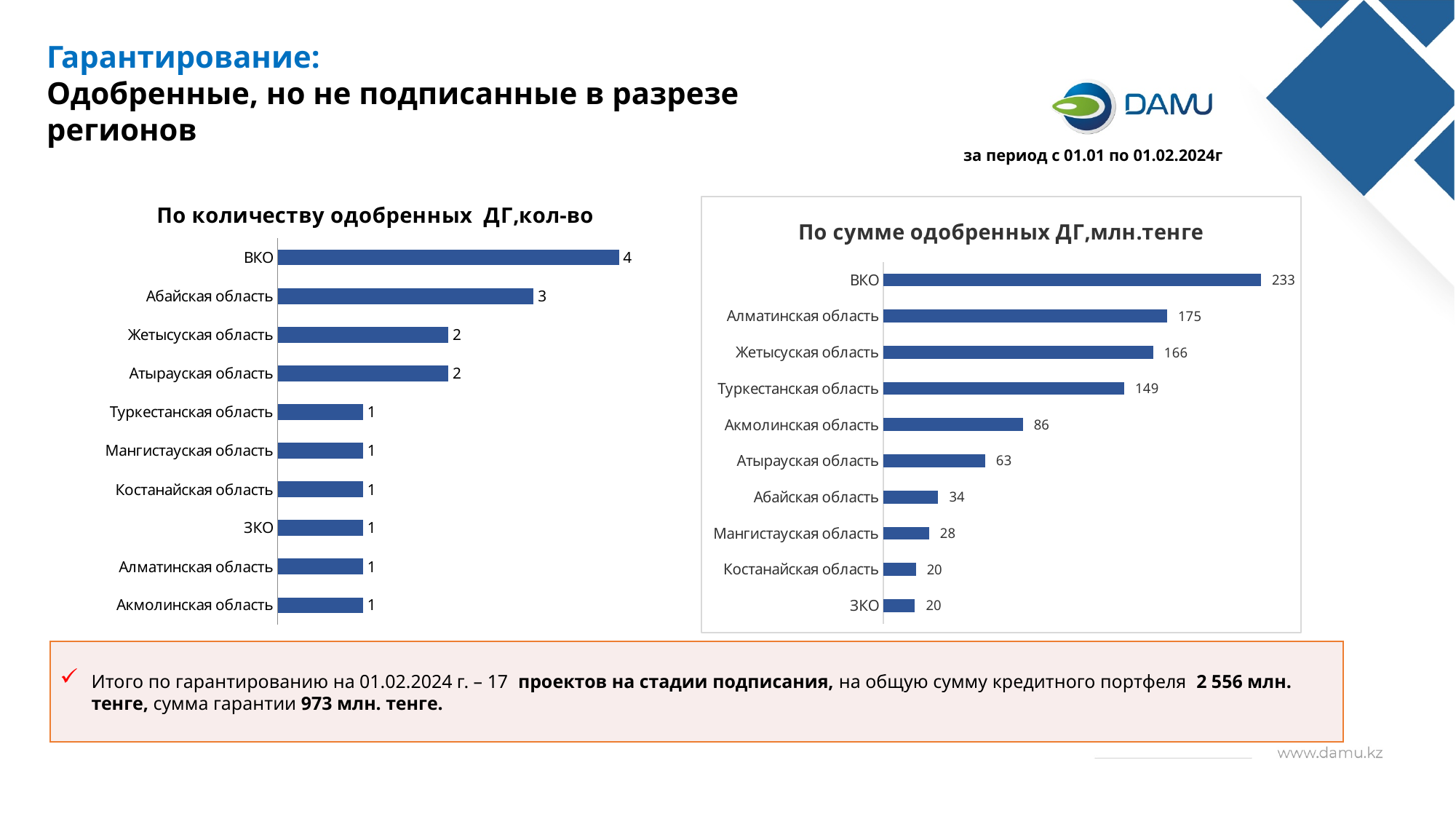
In the chart 'По сумме одобренных ДГ,млн.тенге', which is larger, Атырауская область or Абайская область? Атырауская область In the chart 'По сумме одобренных ДГ,млн.тенге', what is the value for Акмолинская область? 86 In the chart 'По сумме одобренных ДГ,млн.тенге', which region has the highest value? ВКО In the chart 'По сумме одобренных ДГ,млн.тенге', what is the difference between ВКО and Туркестанская область? 84 In the chart 'По количеству одобренных ДГ,кол-во', what is the difference between ВКО and Жетысуская область? 2 What is the title of the chart on the left side of the slide? По количеству одобренных ДГ,кол-во In the chart 'По количеству одобренных ДГ,кол-во', how many regions are shown? 10 In the chart 'По сумме одобренных ДГ,млн.тенге', what is the value for Алматинская область? 175 In the chart 'По количеству одобренных ДГ,кол-во', what is the value for Абайская область? 3 In the chart 'По количеству одобренных ДГ,кол-во', what is the value for ВКО? 4 What type of chart is 'По сумме одобренных ДГ,млн.тенге'? Bar chart In the chart 'По количеству одобренных ДГ,кол-во', which region has the highest value? ВКО